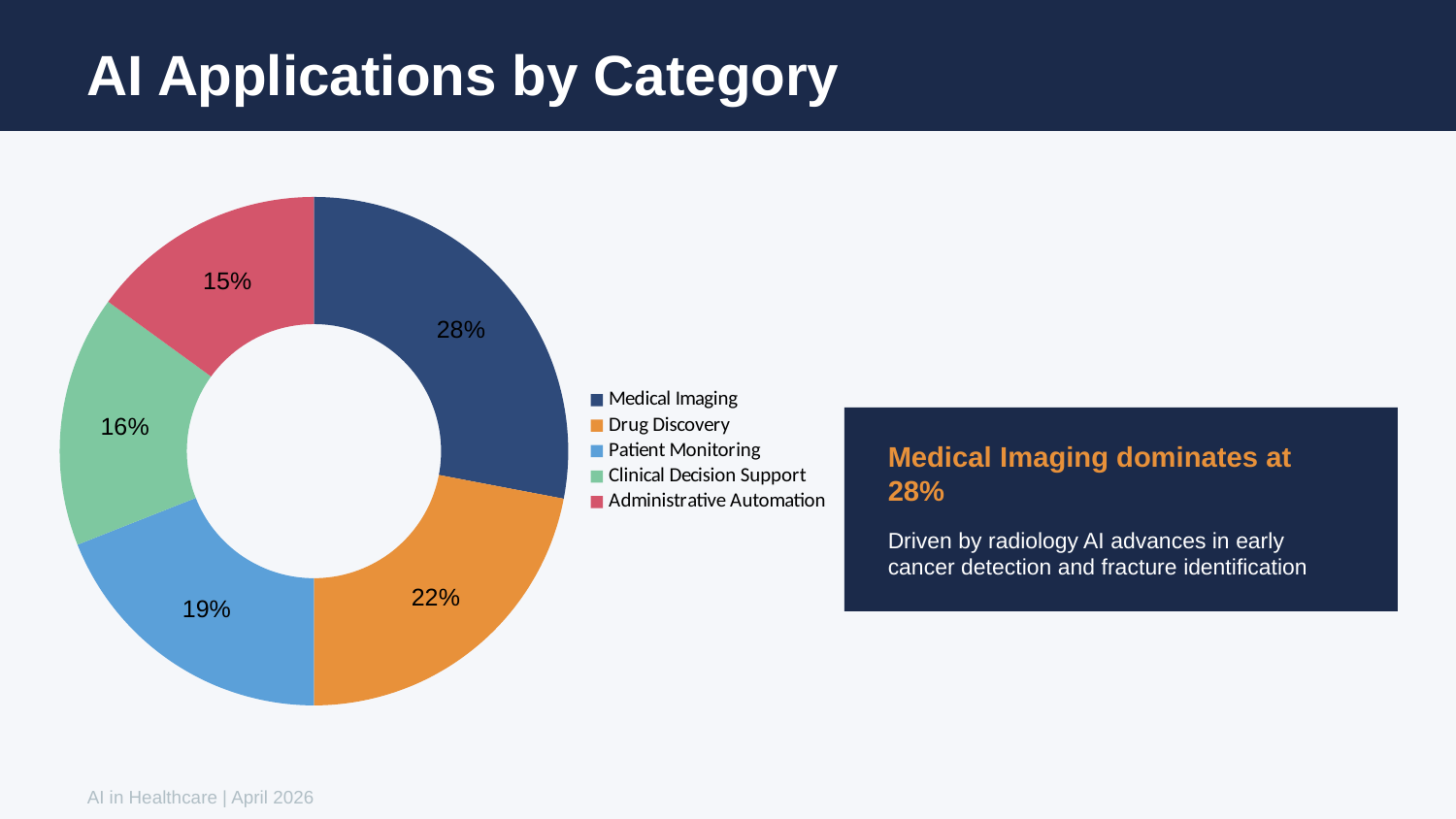
What is the value for Clinical Decision Support? 16% What is the difference between the Medical Imaging and Drug Discovery shares? 6% What kind of chart is shown on the slide? Doughnut chart What is the value for Administrative Automation? 15% How many categories are shown in the chart? 5 What share of the pie does Medical Imaging have? 28% Which is larger, Patient Monitoring or Clinical Decision Support? Patient Monitoring What is the title of the slide? AI Applications by Category Which category has the smallest share? Administrative Automation What is the value for Drug Discovery? 22% Which category has the largest share? Medical Imaging What is the value for Patient Monitoring? 19%